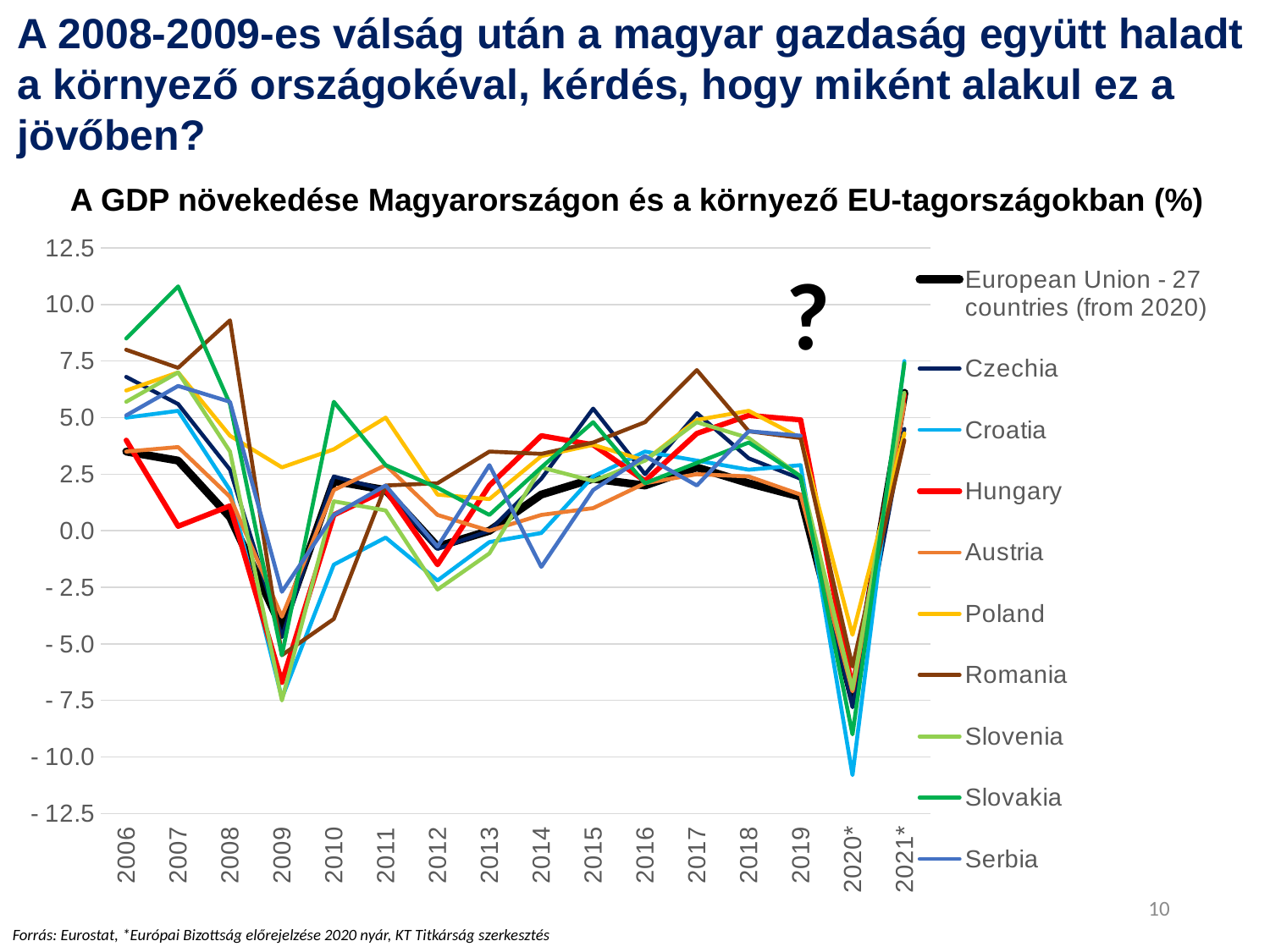
Which series is drawn with the thick black line? European Union - 27 countries (from 2020) Which country has the highest value in 2009? Poland Which country has the highest value in 2007? Slovakia Which country has the lowest value in 2020*? Croatia How many series does the legend list? 10 Is the value for Slovakia in 2007 greater or less than 10.0? greater Does the European Union line rise or fall from 2017 to 2020*? fall What kind of chart is shown on the slide? line chart How many years are shown along the x axis? 16 Is the value for Hungary in 2009 greater or less than -5.0? less Is the value for Croatia in 2020* greater or less than -10.0? less What is the title of the chart? A GDP növekedése Magyarországon és a környező EU-tagországokban (%)